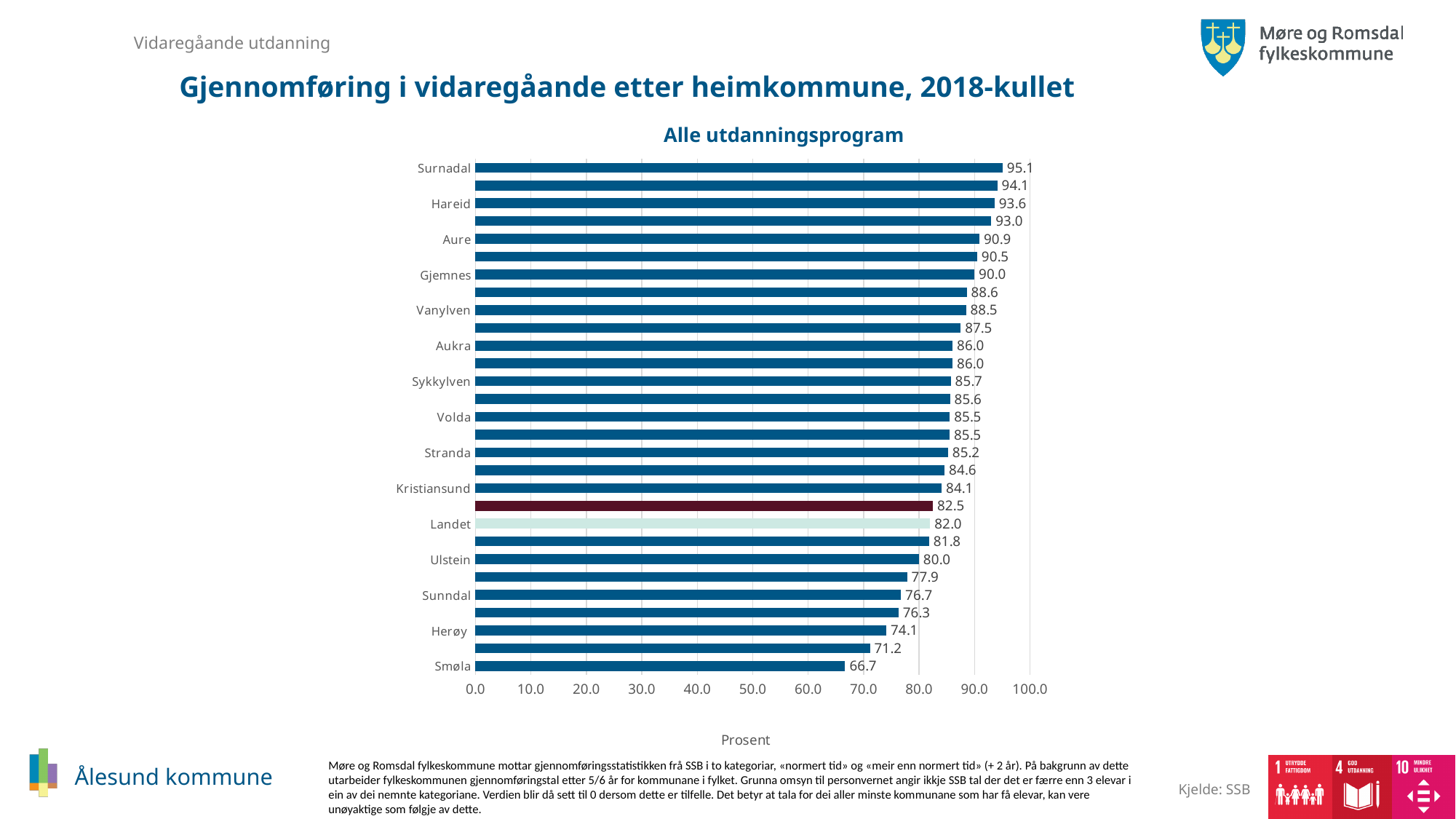
What kind of chart is shown on the slide? bar chart What is the title of the chart? Alle utdanningsprogram Is the value for Sunndal greater or less than 80.0? less What is the difference between the values for Surnadal and Smøla? 28.4 How many bars are plotted in the chart? 29 Which category has the lowest value? Smøla What is the value for Herøy? 74.1 What is the value for Surnadal? 95.1 What is the value for Kristiansund? 84.1 Which is larger, the value for Hareid or the value for Ulstein? Hareid What is the value for Landet? 82.0 Which category has the highest value? Surnadal